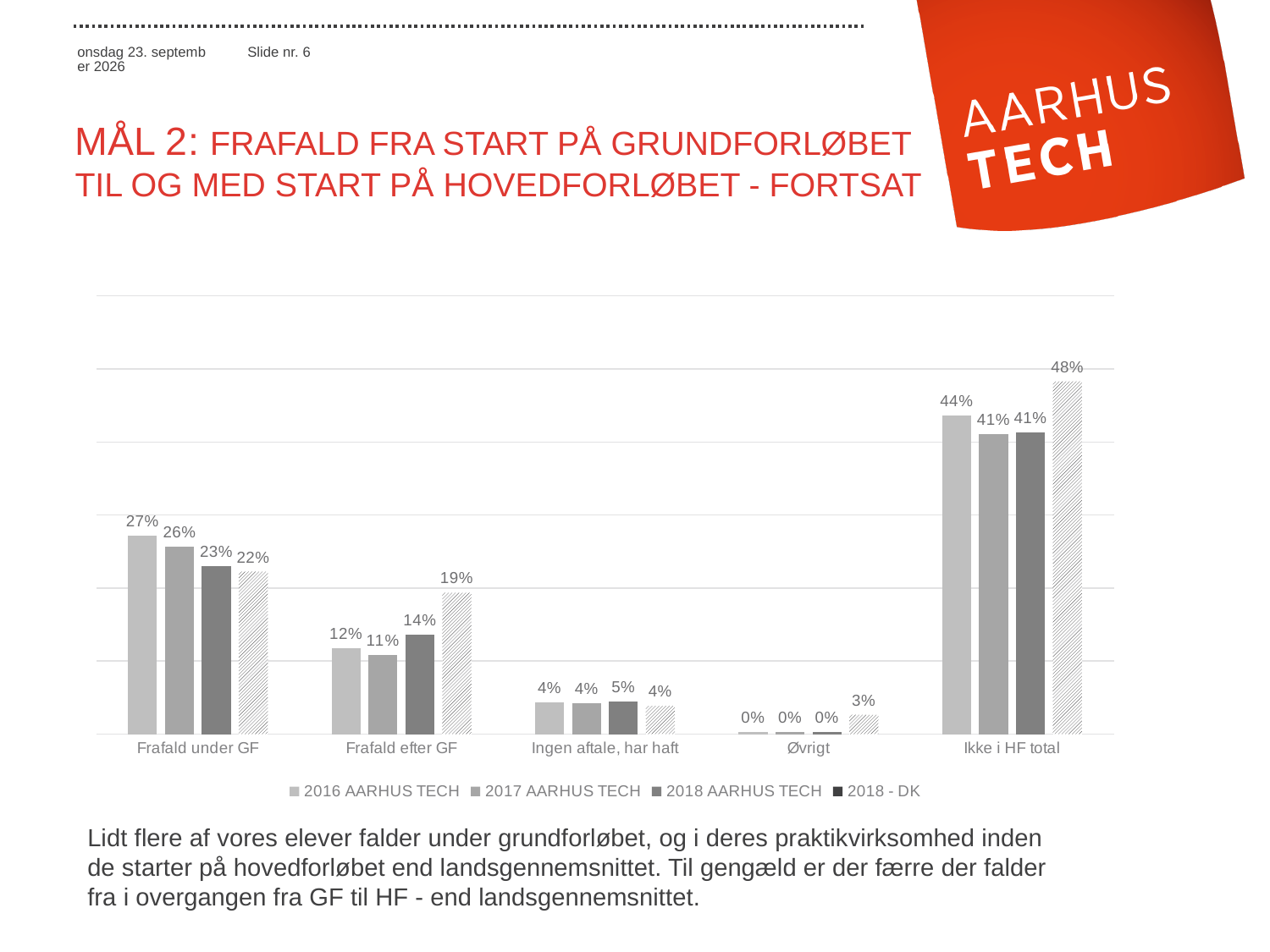
What is the difference between the 2018 - DK value and the 2018 AARHUS TECH value in the "Ikke i HF total" category? 7% What is the value for 2016 AARHUS TECH in the "Frafald under GF" category? 27% In the "Frafald under GF" category, which is larger: the 2016 AARHUS TECH value or the 2018 - DK value? 2016 AARHUS TECH How many categories are shown on the x axis of the chart? 5 How many series does the chart legend list? 4 What is the value for 2018 - DK in the "Frafald efter GF" category? 19% What is the value for 2018 - DK in the "Øvrigt" category? 3% Which category has the lowest value for 2017 AARHUS TECH? Øvrigt What is the value for 2018 AARHUS TECH in the "Ikke i HF total" category? 41% Which series is shown with a hatched (striped) pattern in the chart? 2018 - DK Which category has the highest value for 2018 - DK? Ikke i HF total What kind of chart is shown on the slide? Bar chart